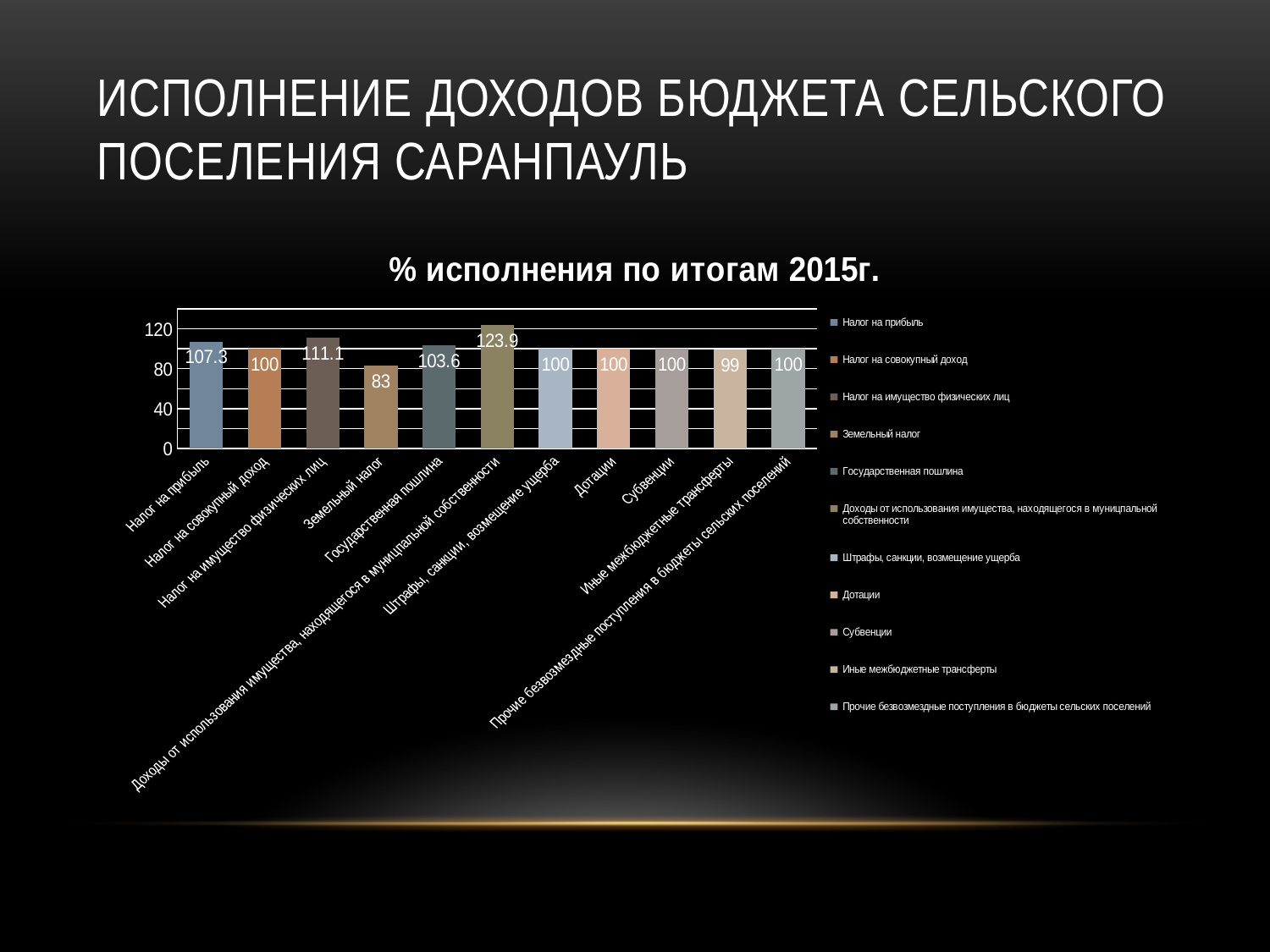
What is the value for Земельный налог? 83 What is the title of the chart? % исполнения по итогам 2015г. Which is larger, the value for Налог на прибыль or the value for Государственная пошлина? Налог на прибыль What is the value for Иные межбюджетные трансферты? 99 What is the value for Налог на прибыль? 107.3 What is the value for Государственная пошлина? 103.6 Is the value for Земельный налог greater or less than 120? less How many categories are shown on the x axis? 11 Which category has the lowest value? Земельный налог What kind of chart is shown on the slide? bar chart Which category has the highest value? Доходы от использования имущества, находящегося в муниципальной собственности What is the difference between the values for Налог на имущество физических лиц and Налог на прибыль? 3.8